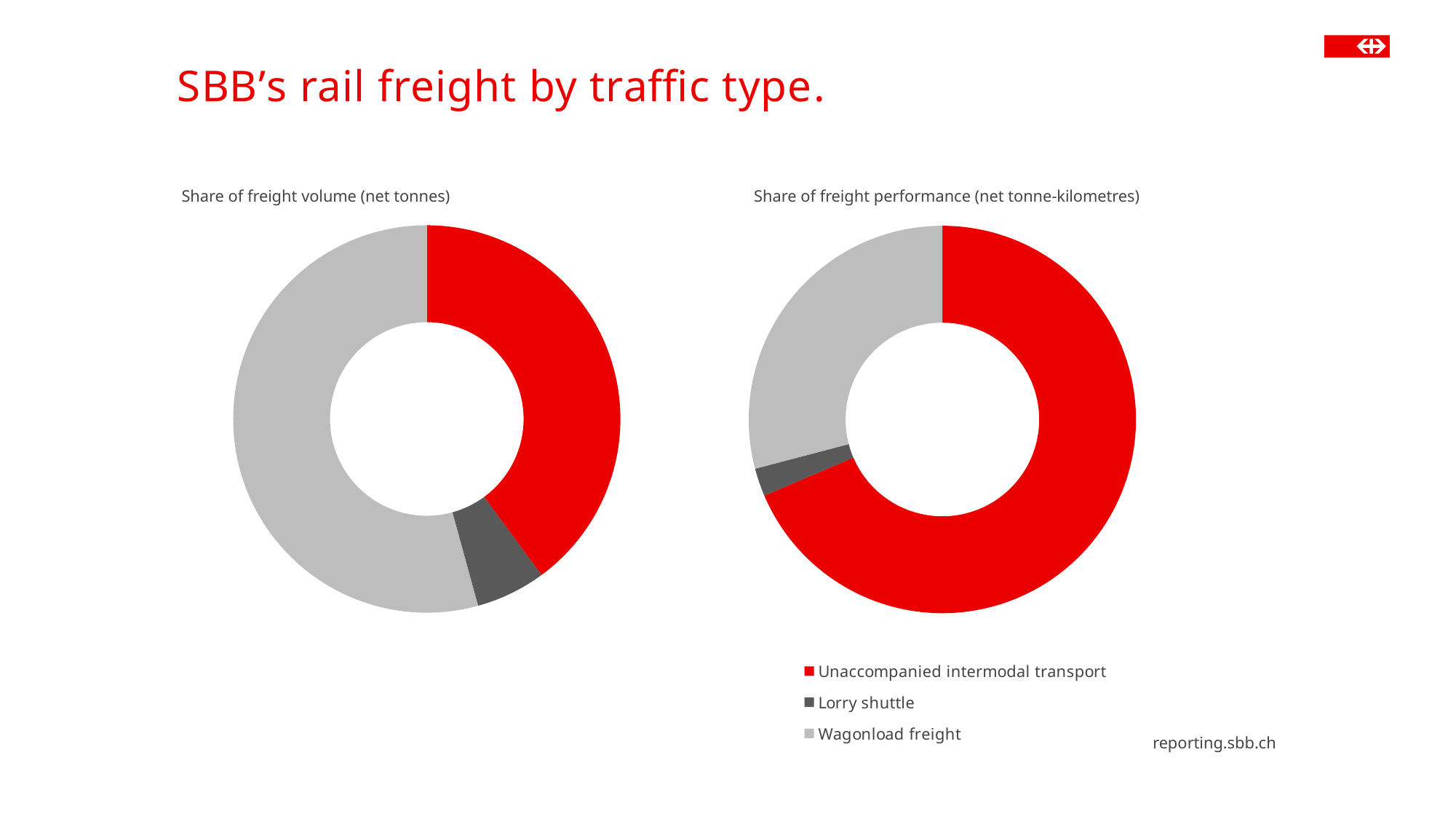
How many charts are shown on this slide? 2 Which colour represents Lorry shuttle in the charts? Dark grey How many categories does the legend list for the charts on this slide? 3 What is the title of the chart on the right of the slide? Share of freight performance (net tonne-kilometres) In the 'Share of freight performance (net tonne-kilometres)' chart, which traffic type has the largest share? Unaccompanied intermodal transport In the 'Share of freight performance (net tonne-kilometres)' chart, which is larger: the share of Unaccompanied intermodal transport or the share of Wagonload freight? Unaccompanied intermodal transport In the 'Share of freight volume (net tonnes)' chart, which traffic type has the largest share? Wagonload freight In the 'Share of freight performance (net tonne-kilometres)' chart, which traffic type has the smallest share? Lorry shuttle In the 'Share of freight volume (net tonnes)' chart, which is larger: the share of Wagonload freight or the share of Unaccompanied intermodal transport? Wagonload freight In the 'Share of freight volume (net tonnes)' chart, which traffic type has the smallest share? Lorry shuttle In the 'Share of freight volume (net tonnes)' chart, which is larger: the share of Lorry shuttle or the share of Unaccompanied intermodal transport? Unaccompanied intermodal transport What kind of chart is used for 'Share of freight volume (net tonnes)'? Doughnut (pie) chart